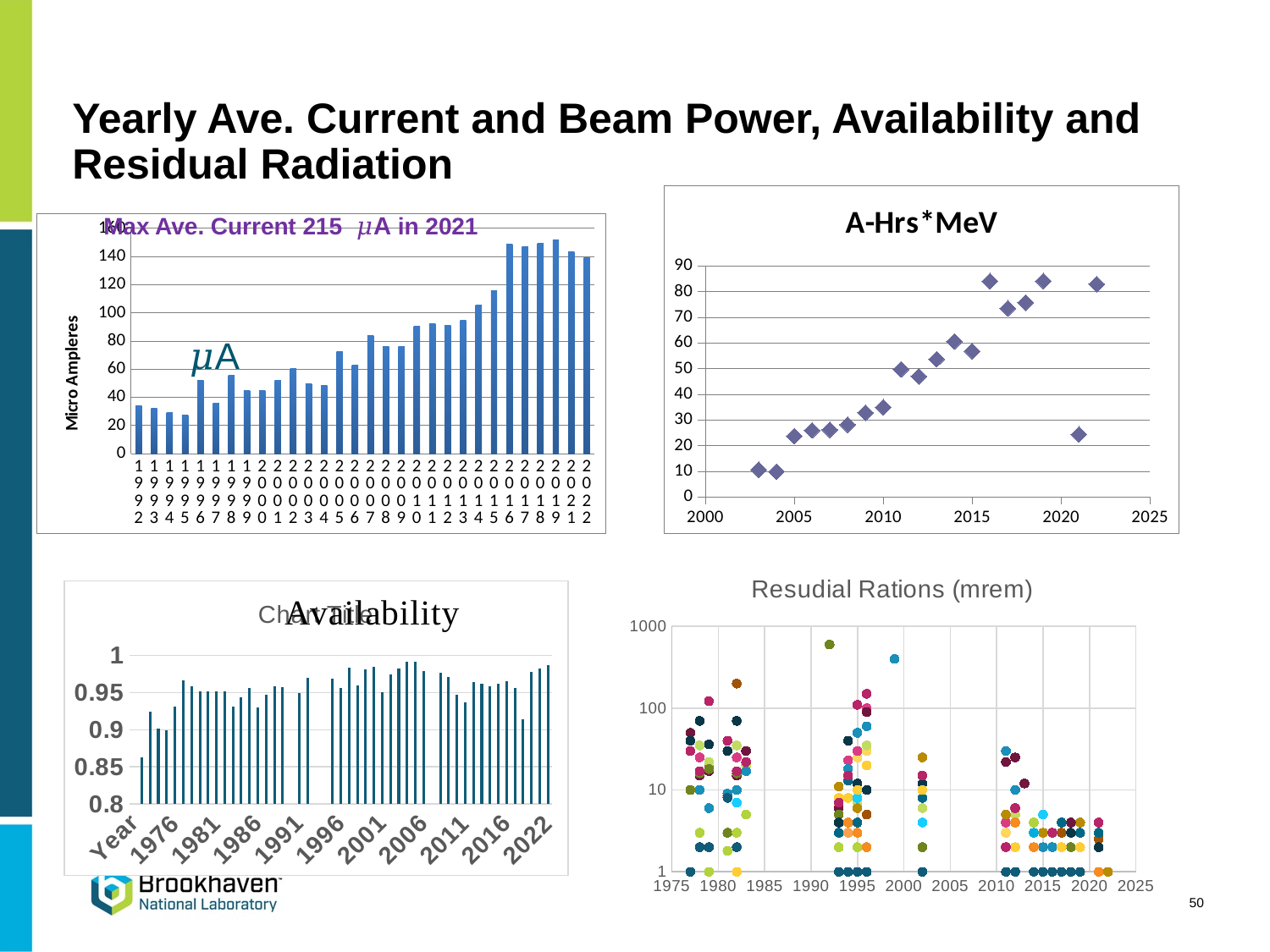
In the top-left Micro Amperes bar chart, how many yearly bars are plotted? 30 In the A-Hrs*MeV chart, is the value for 2021 greater or less than 30? less What type of chart is the top-left chart with the Micro Amperes axis? bar chart What type of chart is the Availability chart? bar chart In the top-left Micro Amperes bar chart, is the value for 2005 greater or less than 80? less In the top-left Micro Amperes bar chart, which is larger, the value for 2010 or the value for 1992? 2010 In the A-Hrs*MeV chart, which is larger, the value for 2014 or the value for 2021? 2014 What is the title of the bottom-right scatter chart? Resudial Rations (mrem) In the top-left Micro Amperes bar chart, is the value for 2019 greater or less than 140? greater What type of chart is the A-Hrs*MeV chart? scatter chart